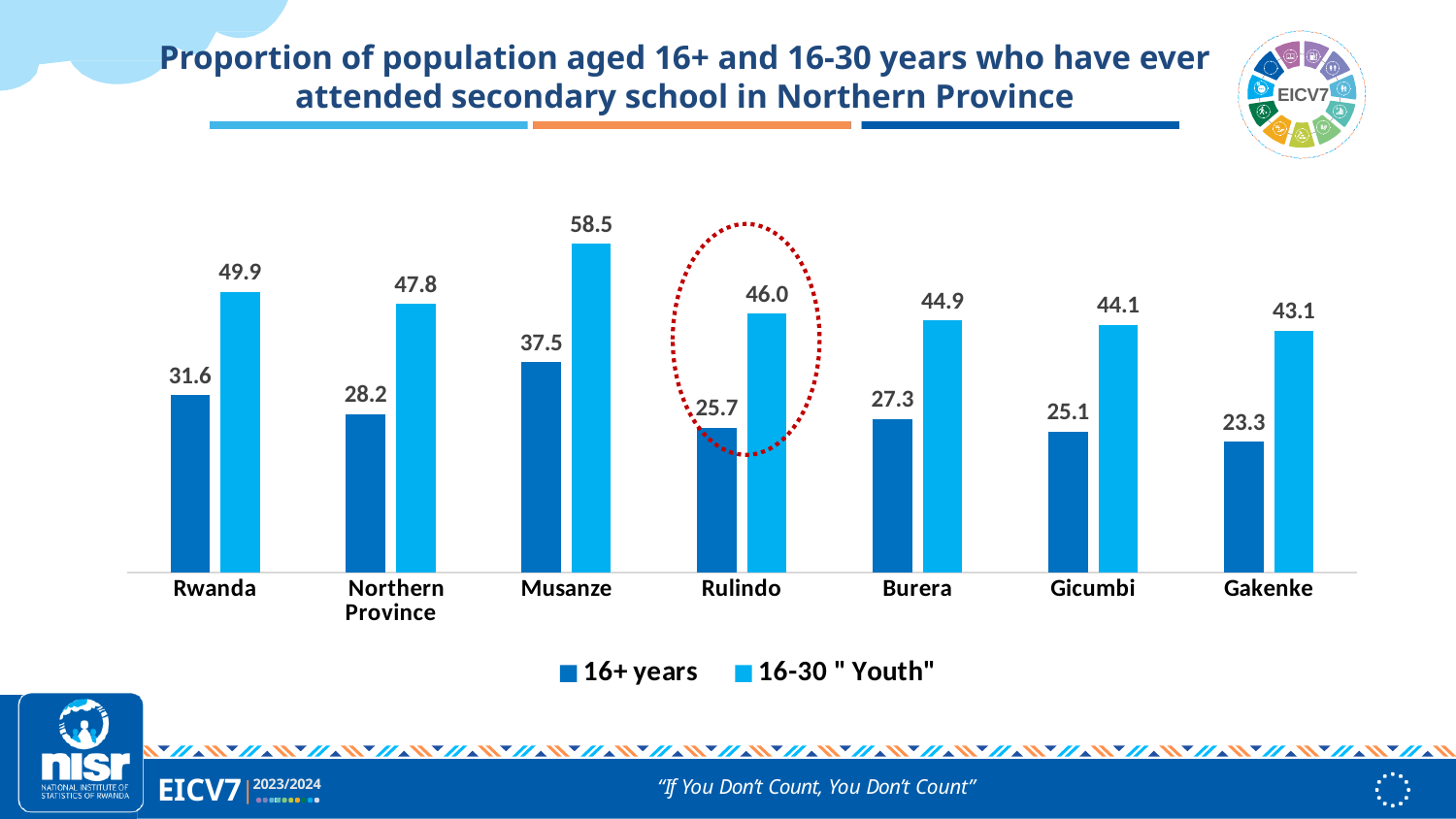
Which is larger: the 16+ years value for Burera or the 16+ years value for Gicumbi? Burera What is the value for the 16+ years series in Musanze? 37.5 Which category has the highest value for the 16-30 "Youth" series? Musanze How many series does the legend list? 2 Which category has the lowest value for the 16+ years series? Gakenke What kind of chart is shown on the slide? Bar chart How many categories are shown on the x axis? 7 Which category is highlighted with a red dotted circle? Rulindo What is the value for the 16-30 "Youth" series in Northern Province? 47.8 What is the value for the 16-30 "Youth" series in Rulindo? 46.0 What is the value for the 16+ years series in Gakenke? 23.3 What is the difference between the 16-30 "Youth" value and the 16+ years value in Rwanda? 18.3